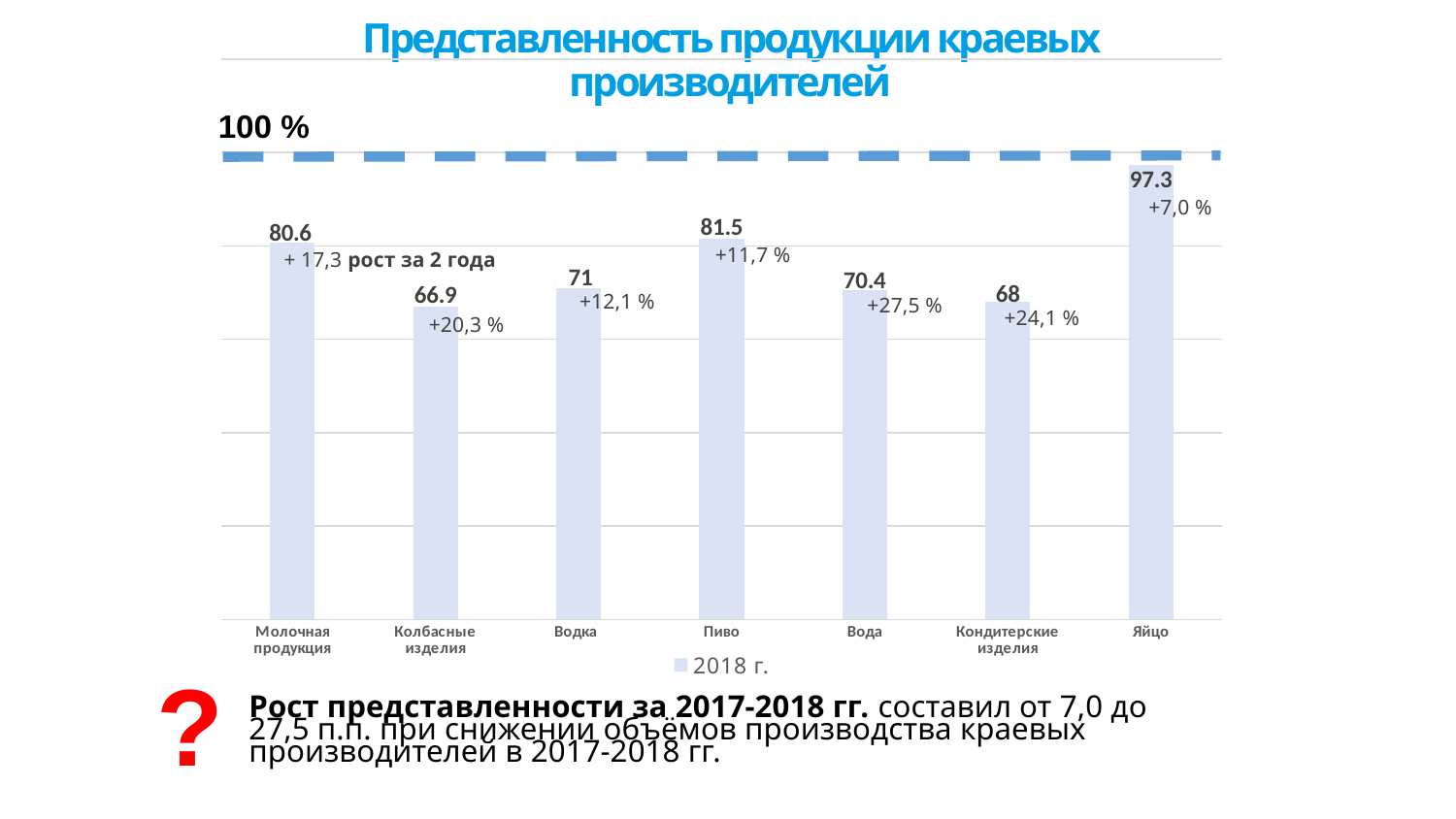
Which is larger, the value for Водка or the value for Кондитерские изделия? Водка Which category has the highest value? Яйцо Which category has the lowest value? Колбасные изделия What series name is shown in the legend? 2018 г. What is the difference between the values for Яйцо and Пиво? 15.8 What is the value for Яйцо? 97.3 What type of chart is shown on the slide? Bar chart How many series does the legend list? 1 What is the value for Вода? 70.4 What is the value for Колбасные изделия? 66.9 How many categories are shown on the x axis? 7 What is the value for Молочная продукция? 80.6